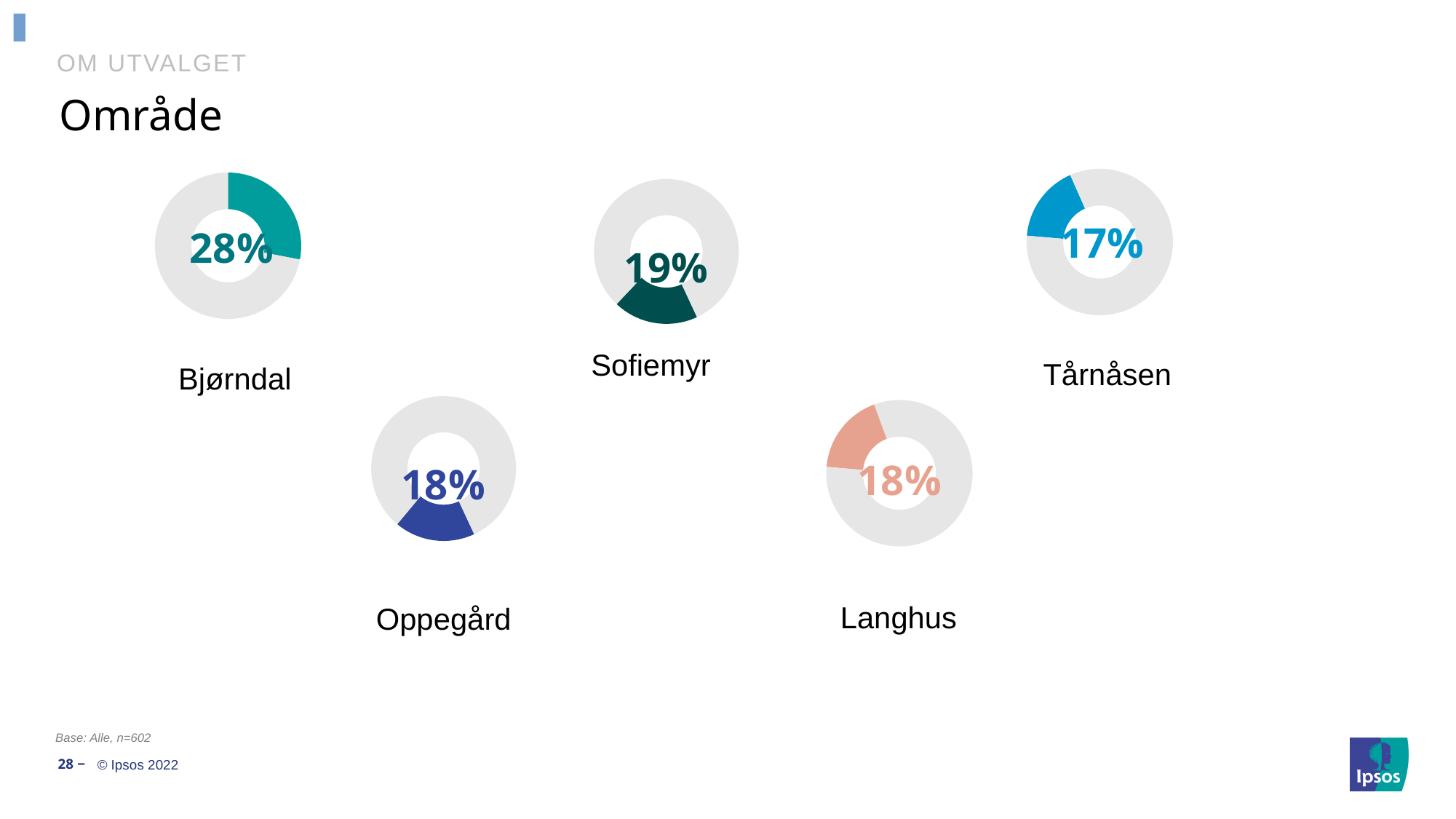
Which is larger, the percentage for Sofiemyr or the percentage for Tårnåsen? Sofiemyr How many donut charts are shown on the slide? 5 Which area has the lowest percentage across the donut charts on the slide? Tårnåsen What percentage is shown in the Bjørndal donut chart? 28% What percentage is shown in the Oppegård donut chart? 18% What percentage is shown in the Sofiemyr donut chart? 19% Which area has the highest percentage across the donut charts on the slide? Bjørndal What is the difference in percentage points between the Bjørndal chart and the Tårnåsen chart? 11 What percentage is shown in the Tårnåsen donut chart? 17% What kind of chart is used for each area on the slide? Donut chart What colour is the filled segment of the Langhus donut chart? Salmon/light orange What percentage is shown in the Langhus donut chart? 18%